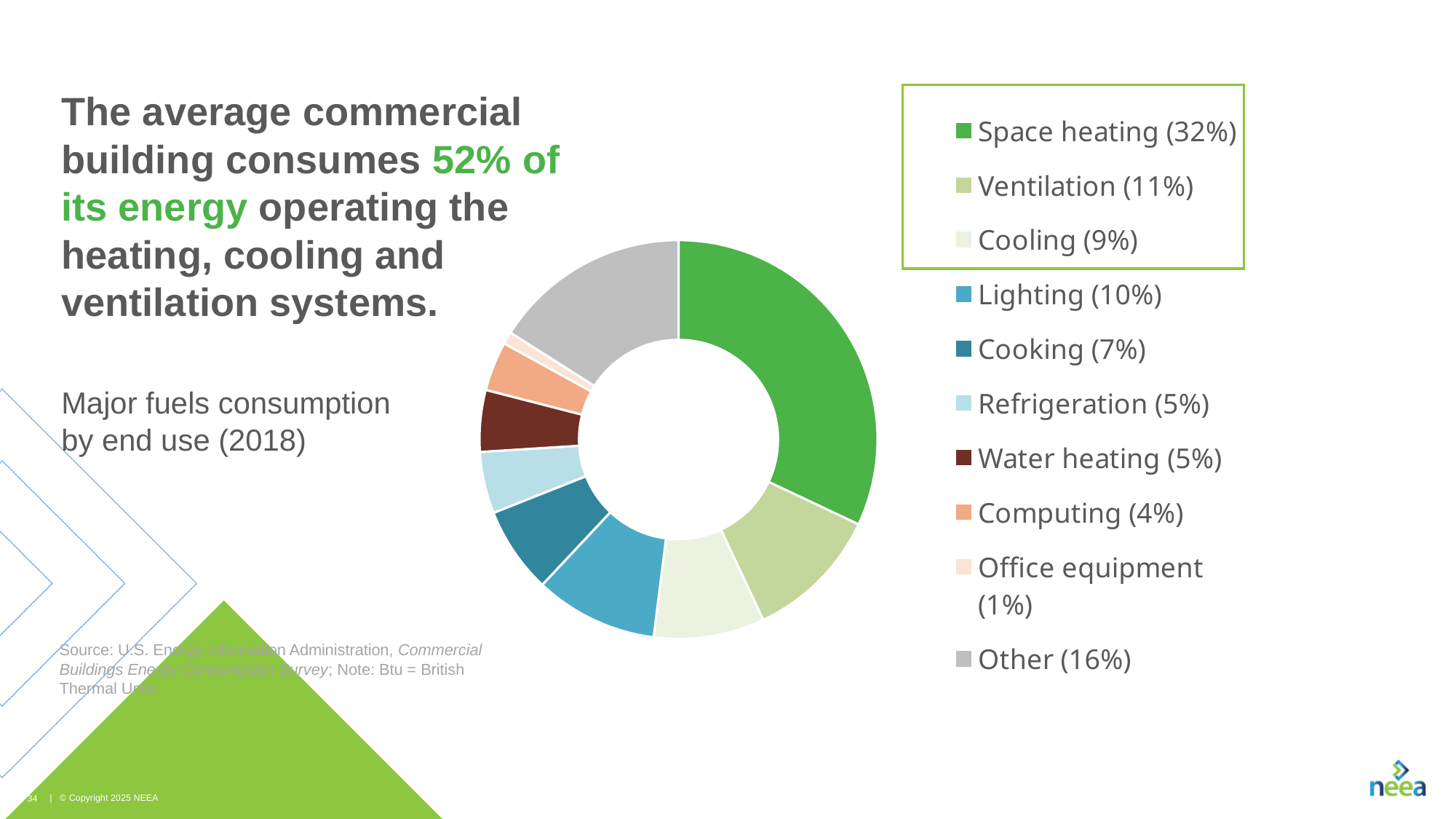
Which has a larger share, Cooking or Computing? Cooking How many end-use categories are shown in the chart? 10 What share of major fuels consumption is attributed to Lighting? 10% What is the title of the chart? Major fuels consumption by end use (2018) What is the difference in percentage points between the Space heating share and the Other share? 16 Which has a larger share, Lighting or Ventilation? Ventilation Which end use has the smallest share of major fuels consumption? Office equipment Which end use has the largest share of major fuels consumption? Space heating What kind of chart is shown on the slide? Pie chart (donut) What share of major fuels consumption is attributed to Office equipment? 1% What share of major fuels consumption is attributed to Space heating? 32% What is the difference in percentage points between the Ventilation share and the Cooling share? 2